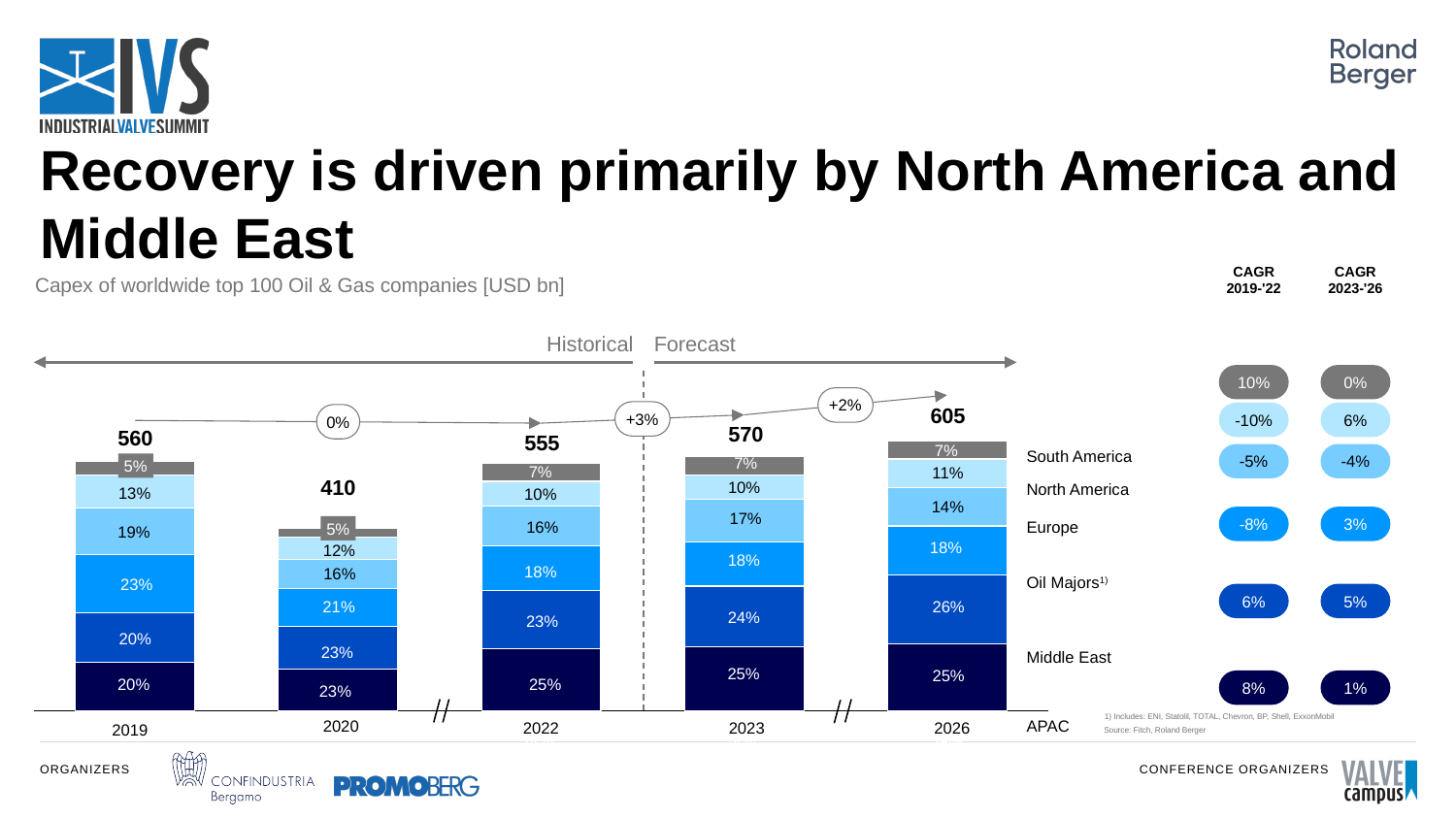
Which year has the lowest total capex? 2020 How many years are shown as bars in the chart? 5 What kind of chart is used to show the capex data? Stacked bar chart Which year has the highest total capex? 2026 What is the CAGR 2019-'22 shown for North America? -10% How many regional segments make up each stacked bar? 6 What share of capex does the Middle East account for in 2026? 26% Do the total capex values rise or fall from 2020 to 2026? Rise Is Europe's share of capex larger in 2019 or in 2026? 2019 What share of capex does APAC account for in 2019? 20% What is the total capex shown for 2019? 560 What is the difference between the total capex in 2026 and in 2023? 35